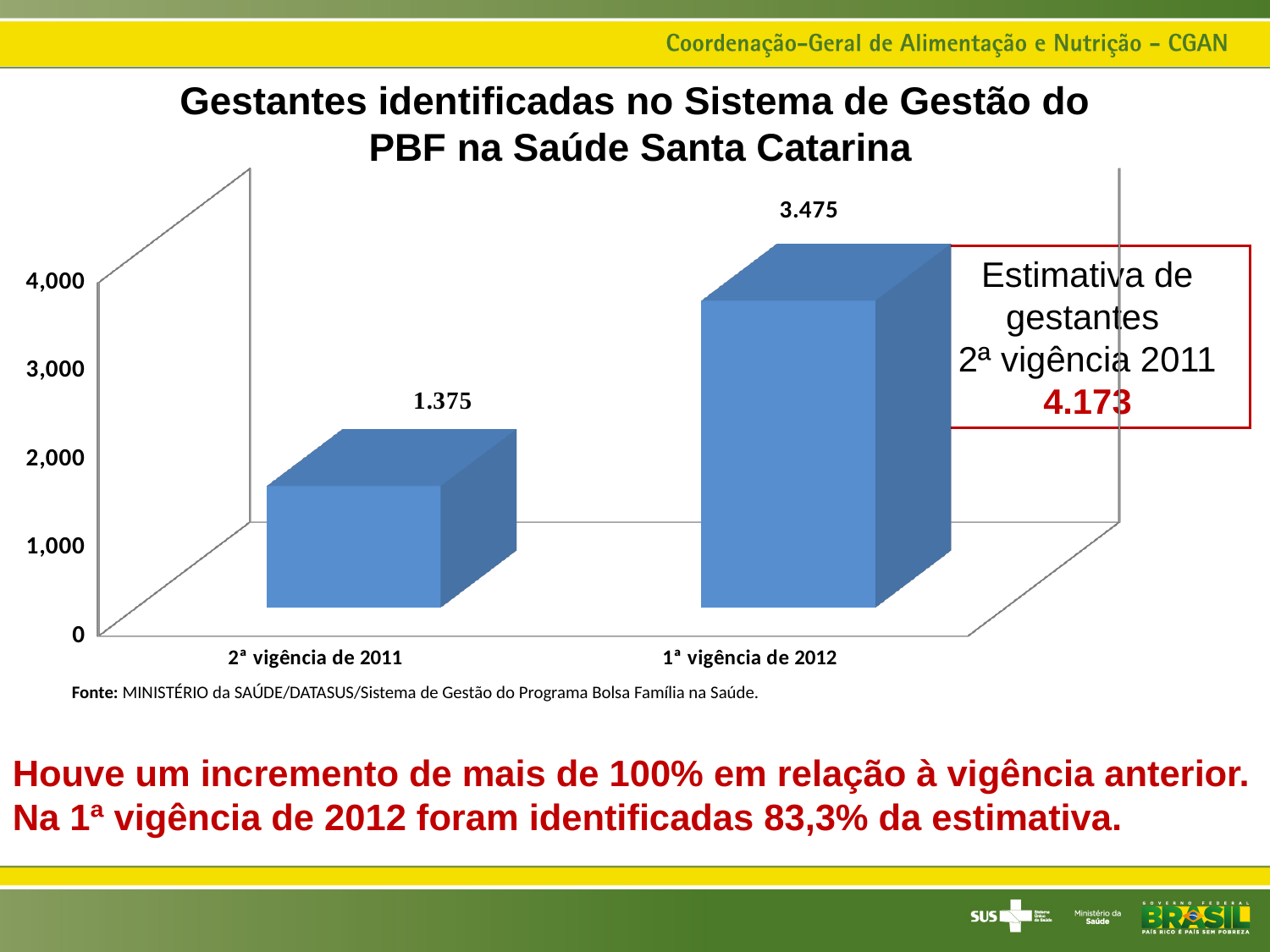
Do the values rise or fall from 2ª vigência de 2011 to 1ª vigência de 2012? rise Is the value for 2ª vigência de 2011 greater or less than 2,000? less What is the difference between the values for 1ª vigência de 2012 and 2ª vigência de 2011? 2.100 What is the value for 2ª vigência de 2011? 1.375 What is the value for 1ª vigência de 2012? 3.475 Is the value for 1ª vigência de 2012 greater or less than 3,000? greater Which category has the highest value? 1ª vigência de 2012 What kind of chart is shown on the slide? bar chart Which category has the lowest value? 2ª vigência de 2011 What is the title of the chart? Gestantes identificadas no Sistema de Gestão do PBF na Saúde Santa Catarina How many categories are shown on the x axis? 2 Which is larger, the value for 2ª vigência de 2011 or the value for 1ª vigência de 2012? 1ª vigência de 2012